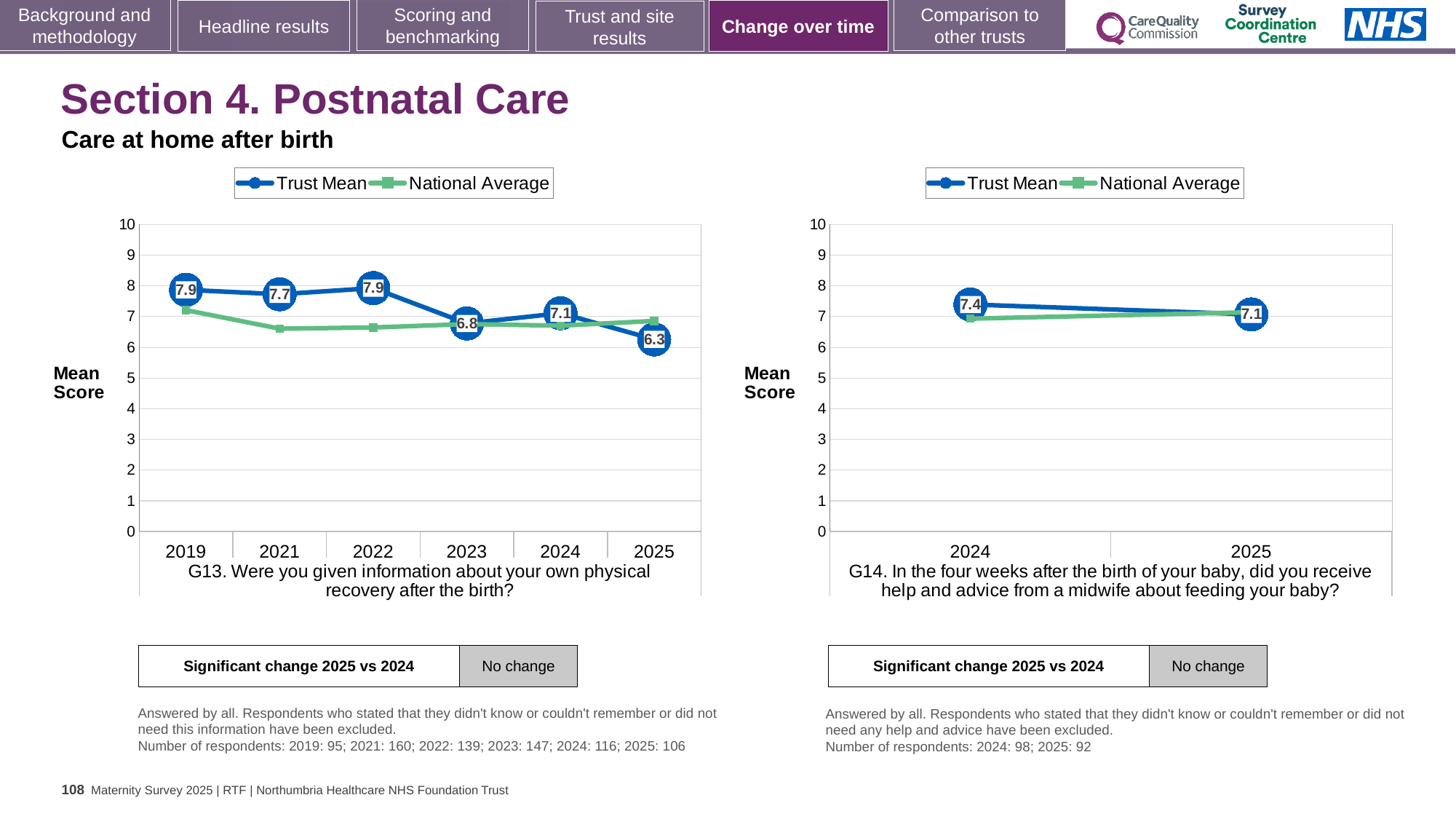
In the right chart (G14), how many series does the legend list? 2 In the left chart (G13), is the National Average for 2021 greater or less than 7? less In the left chart (G13), what is the Trust Mean for 2019? 7.9 In the left chart (G13), what is the Trust Mean for 2025? 6.3 In the left chart (G13), what is the Trust Mean for 2023? 6.8 In the left chart (G13), which year has the lowest Trust Mean? 2025 In the left chart (G13), how many years are shown on the x axis? 6 In the left chart (G13), what is the difference between the Trust Mean in 2024 and in 2025? 0.8 In the right chart (G14), what is the Trust Mean for 2024? 7.4 What kind of chart is the left chart (G13)? line chart In the right chart (G14), what is the Trust Mean for 2025? 7.1 In the right chart (G14), does the Trust Mean rise or fall from 2024 to 2025? fall